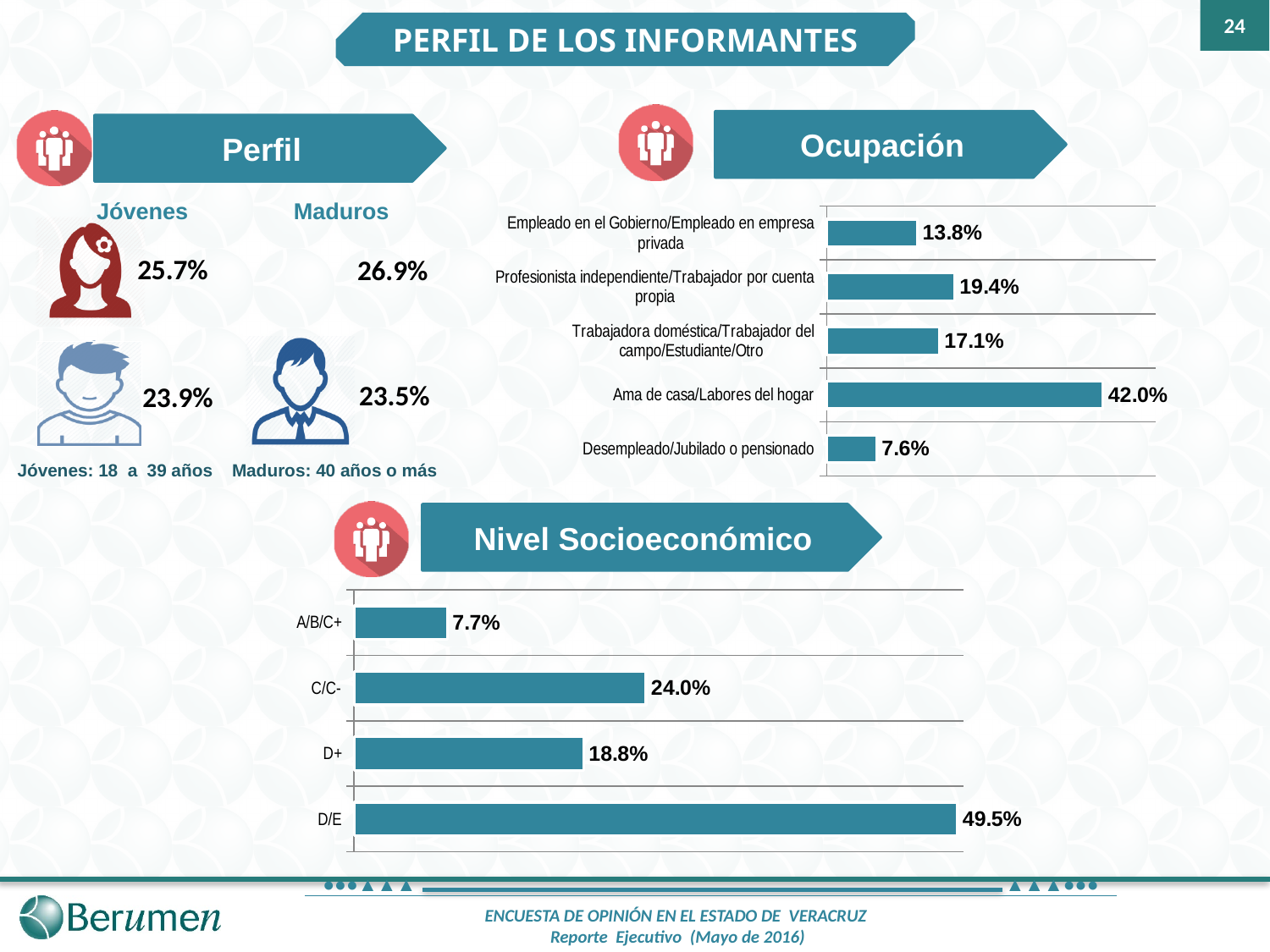
In the Nivel Socioeconómico chart, which is larger, C/C- or D+? C/C- In the Ocupación chart, which category has the lowest value? Desempleado/Jubilado o pensionado In the Nivel Socioeconómico chart, which category has the highest value? D/E In the Ocupación chart, what is the difference between Profesionista independiente/Trabajador por cuenta propia and Empleado en el Gobierno/Empleado en empresa privada? 5.6% In the Nivel Socioeconómico chart, what is the difference between D/E and C/C-? 25.5% In the Nivel Socioeconómico chart, what is the value for D+? 18.8% In the Nivel Socioeconómico chart, which category has the lowest value? A/B/C+ In the Ocupación chart, how many categories are shown? 5 In the Ocupación chart, which category has the highest value? Ama de casa/Labores del hogar What kind of chart is the Nivel Socioeconómico chart? Bar chart In the Ocupación chart, what is the value for Ama de casa/Labores del hogar? 42.0% In the Ocupación chart, what is the value for Profesionista independiente/Trabajador por cuenta propia? 19.4%